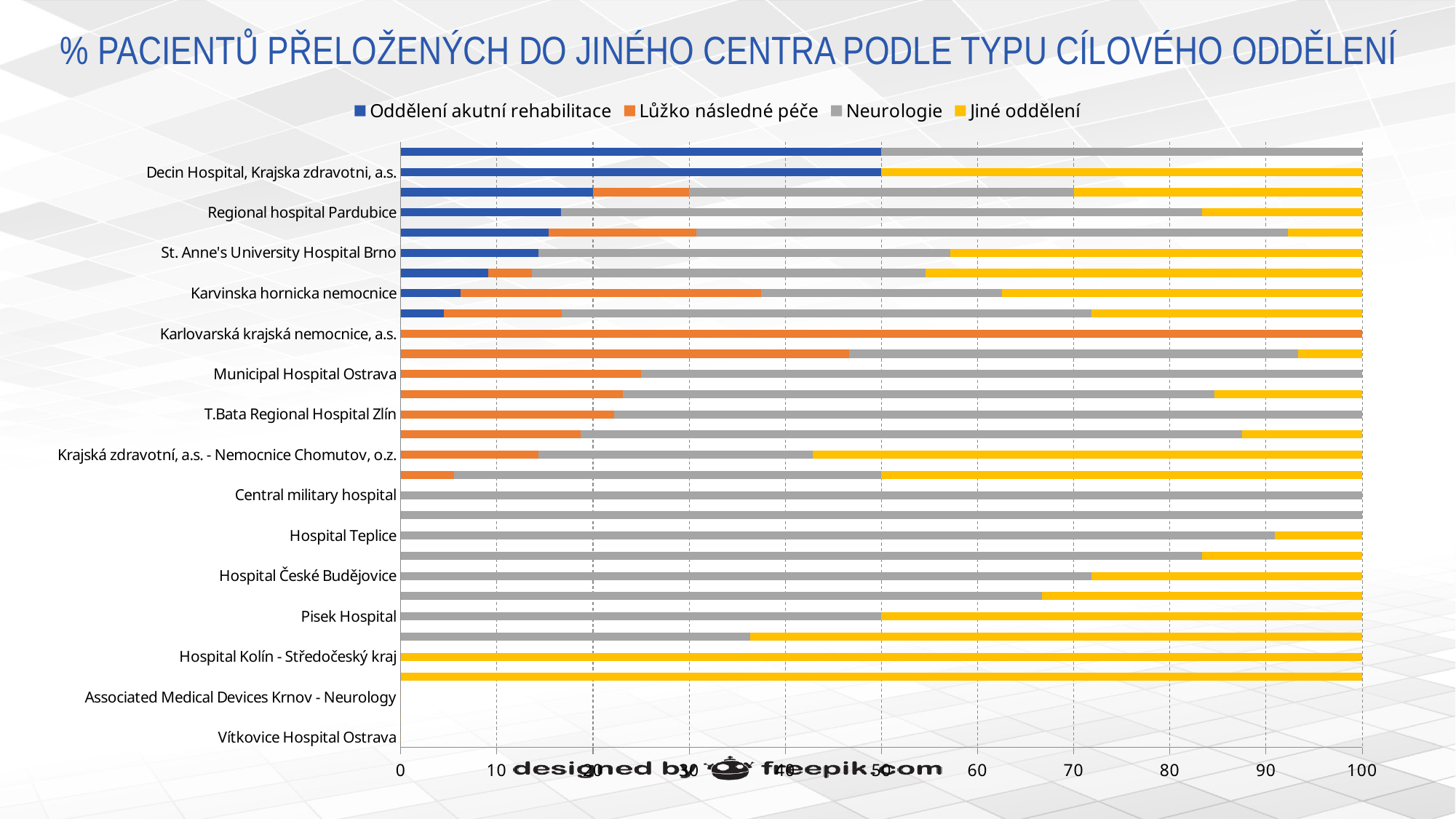
How many series does the legend list? 4 Is the value of Jiné oddělení for Krajská zdravotní, a.s. - Nemocnice Chomutov, o.z. greater or less than 50? greater What is the value of Neurologie for Central military hospital? 100 Which series is shown in orange in the legend? Lůžko následné péče What is the value of Neurologie for Pisek Hospital? 50 What is the value of Oddělení akutní rehabilitace for Decin Hospital, Krajska zdravotni, a.s.? 50 What is the title of the chart? % PACIENTŮ PŘELOŽENÝCH DO JINÉHO CENTRA PODLE TYPU CÍLOVÉHO ODDĚLENÍ What is the value of Lůžko následné péče for Karlovarská krajská nemocnice, a.s.? 100 What is the value of Jiné oddělení for Hospital Kolín - Středočeský kraj? 100 Which has the larger value of Oddělení akutní rehabilitace: Decin Hospital, Krajska zdravotni, a.s. or Regional hospital Pardubice? Decin Hospital, Krajska zdravotni, a.s. What kind of chart is shown on the slide? Stacked bar chart Is the value of Oddělení akutní rehabilitace for Regional hospital Pardubice greater or less than 20? less